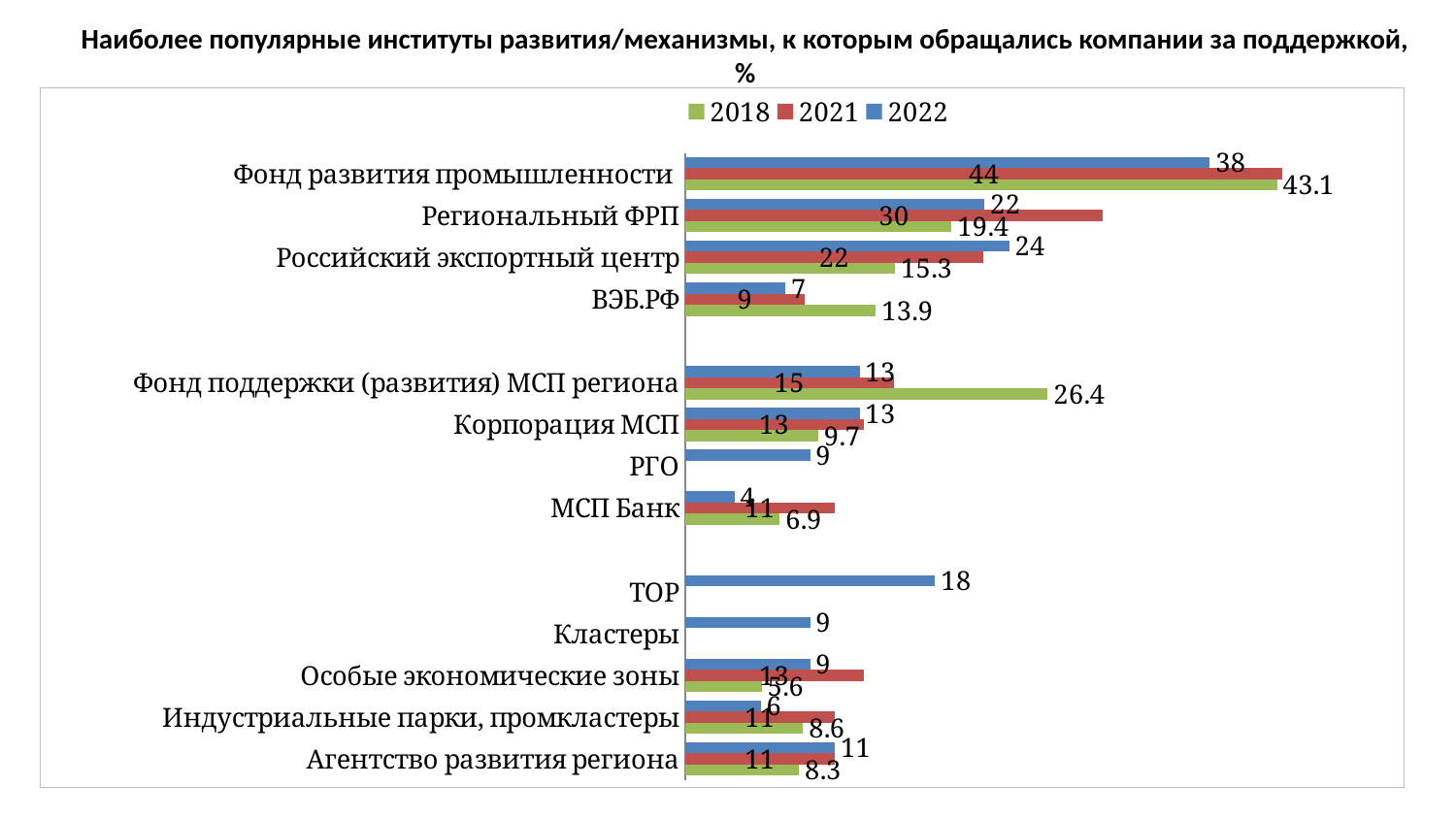
For Российский экспортный центр, which year has the larger value, 2021 or 2022? 2022 What is the difference between the 2021 and 2022 values for Фонд развития промышленности? 6 What is the 2018 value for Фонд поддержки (развития) МСП региона? 26.4 How many series does the legend list? 3 What is the 2018 value for Фонд развития промышленности? 43.1 Which category has the highest 2022 value? Фонд развития промышленности What kind of chart is shown on the slide? Bar chart Which years are listed in the legend? 2018, 2021, 2022 What is the 2022 value for ТОР? 18 How many categories are shown on the chart? 13 What is the 2021 value for Региональный ФРП? 30 Which category has the lowest 2022 value? МСП Банк